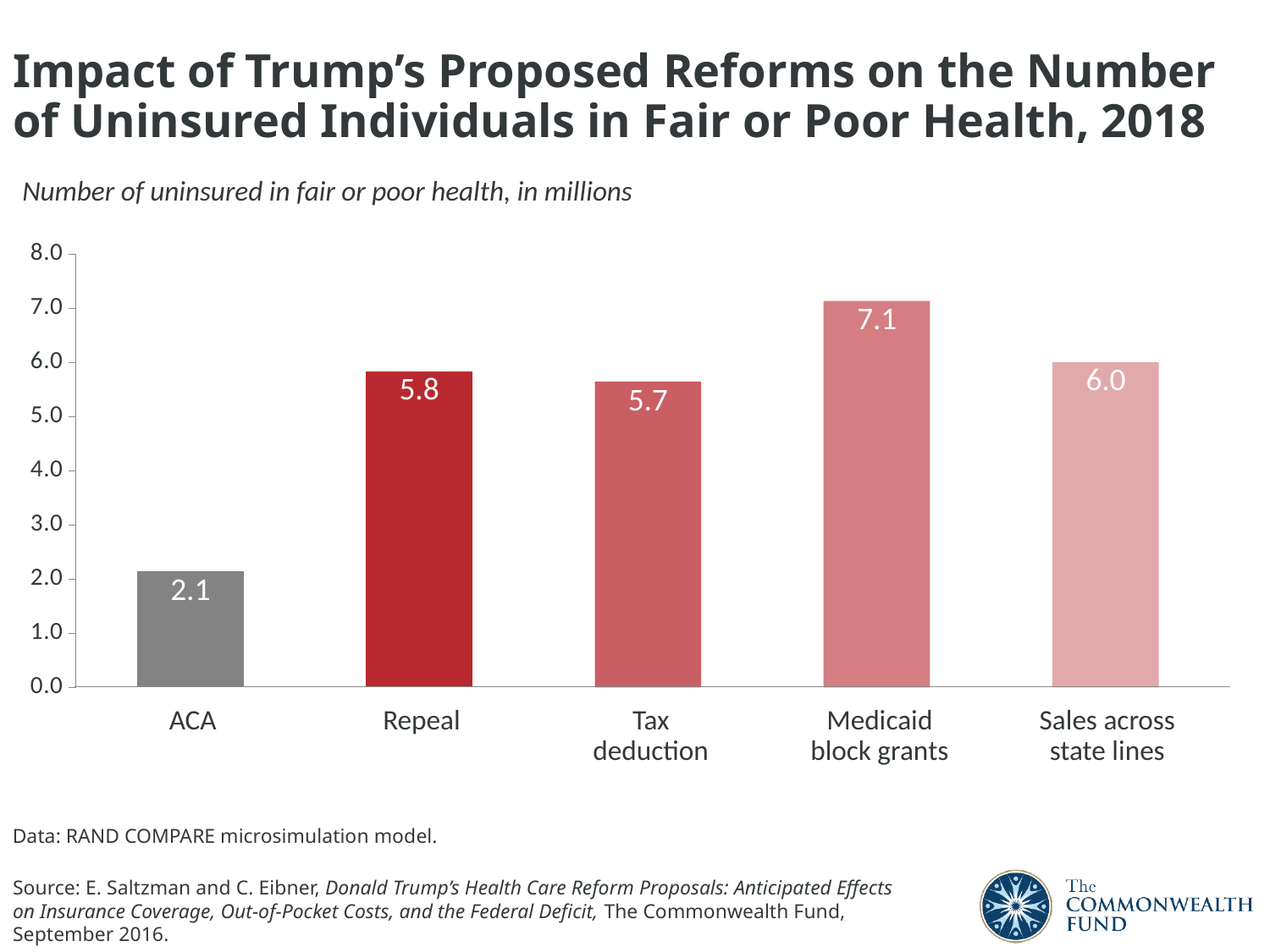
Is the value for Tax deduction greater or less than 6.0? less What kind of chart is shown on the slide? Bar chart What is the value shown for Sales across state lines? 6.0 What is the value shown for Medicaid block grants? 7.1 Which is larger, the value for Sales across state lines or the value for Repeal? Sales across state lines How many categories are shown on the x axis? 5 What is the difference in millions between Repeal and Tax deduction? 0.1 What is the difference in millions between Medicaid block grants and ACA? 5.0 What is the number of uninsured in fair or poor health (in millions) under the ACA? 2.1 Which category has the lowest number of uninsured in fair or poor health? ACA Which category has the highest number of uninsured in fair or poor health? Medicaid block grants What is the unit of measurement stated in the chart subtitle? Millions